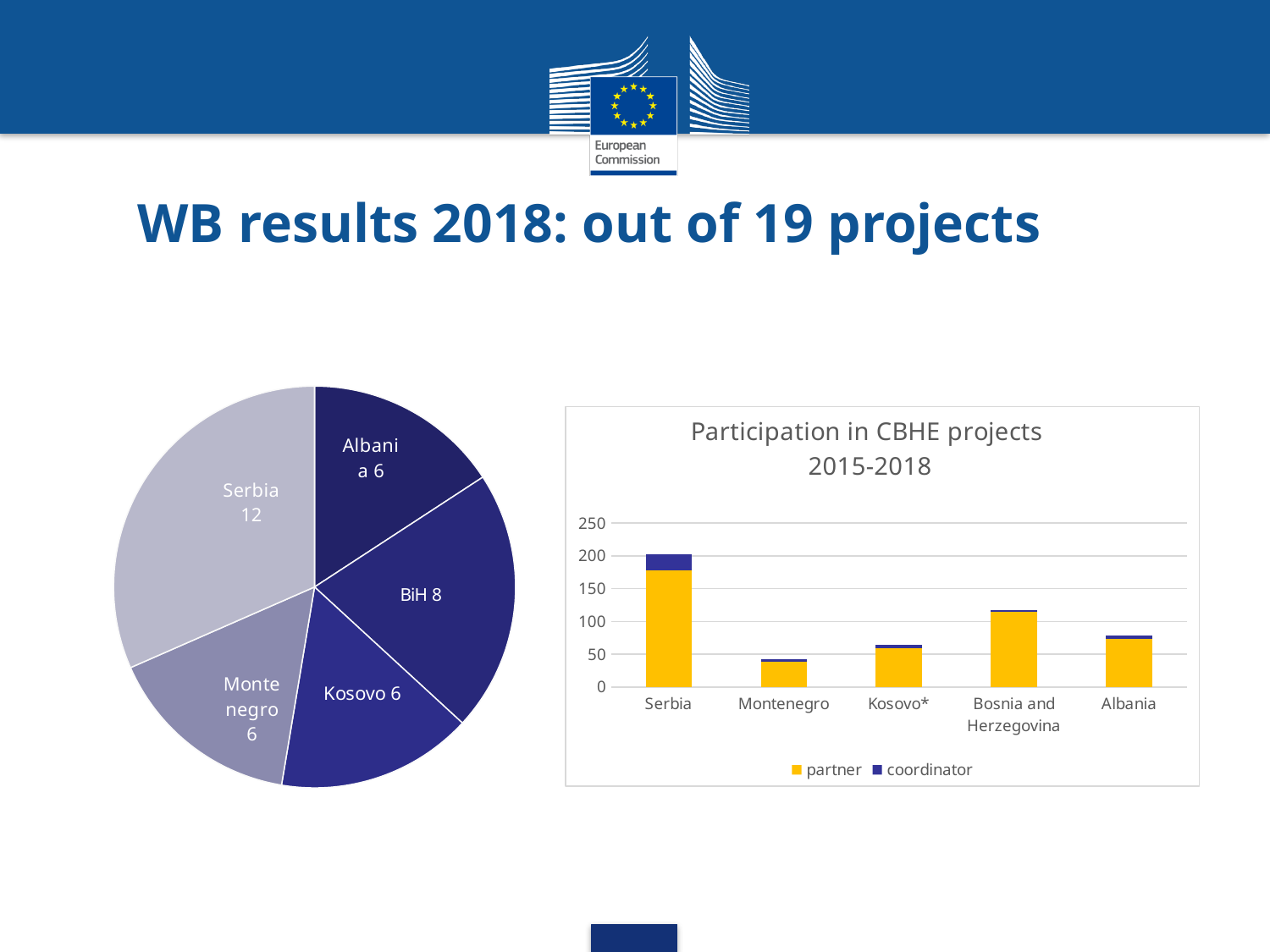
What kind of chart is the 'Participation in CBHE projects 2015-2018' chart? Stacked bar chart In the 'Participation in CBHE projects 2015-2018' chart, is the total bar for Montenegro greater or less than 50? less On the pie chart on the left, which category has the largest slice? Serbia In the 'Participation in CBHE projects 2015-2018' chart, which country has the shortest bar? Montenegro On the pie chart on the left, what is the difference between the values for Serbia and BiH? 4 On the pie chart on the left, how many categories are shown? 5 On the pie chart on the left, what is the value for Serbia? 12 In the 'Participation in CBHE projects 2015-2018' chart, which country has the tallest bar? Serbia In the 'Participation in CBHE projects 2015-2018' chart, is the total bar for Serbia greater or less than 150? greater On the pie chart on the left, which is larger, the value for BiH or the value for Kosovo? BiH In the 'Participation in CBHE projects 2015-2018' chart, how many series does the legend list? 2 On the pie chart on the left, what is the value for BiH? 8